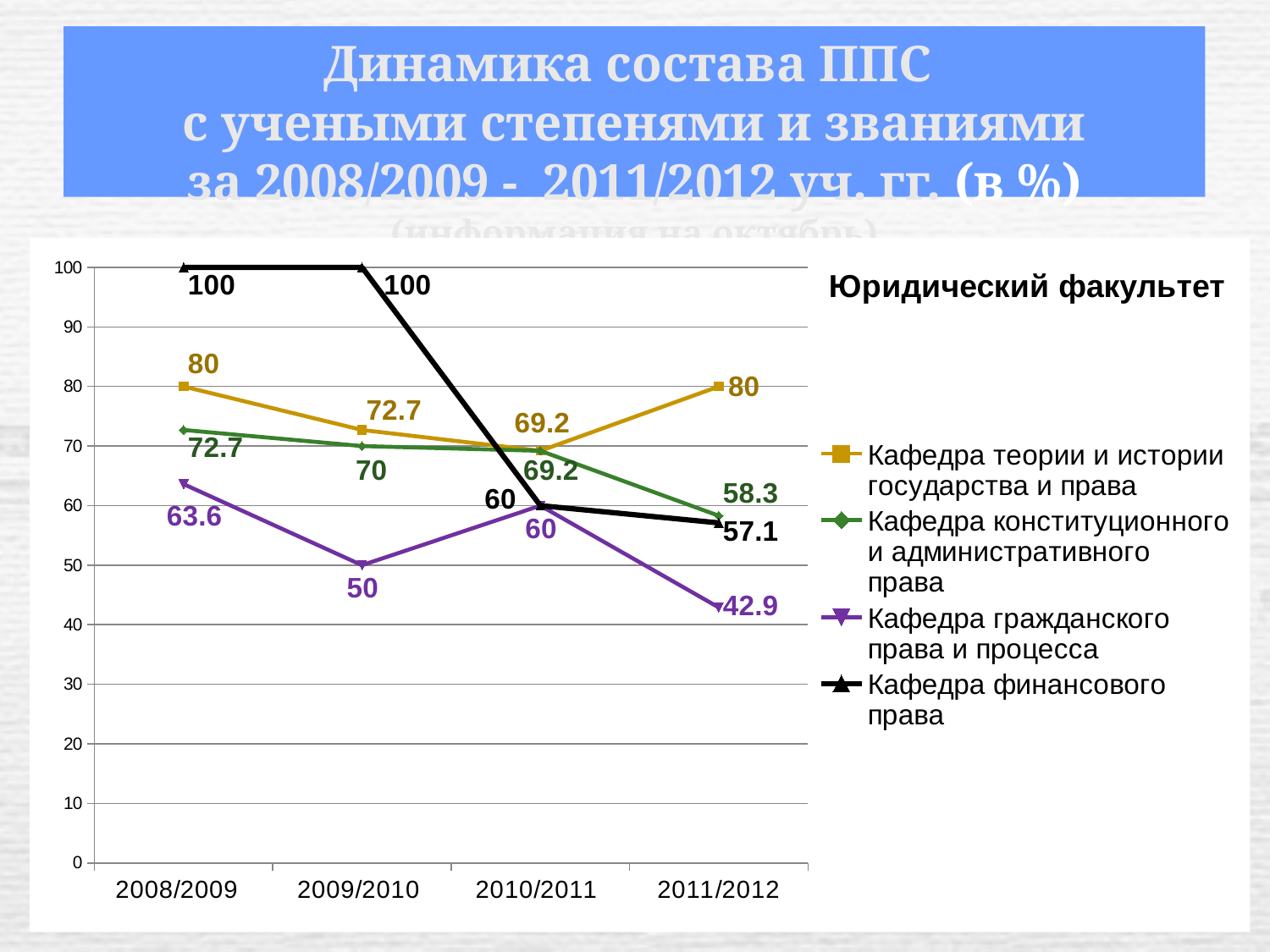
Which series has the highest value in 2011/2012? Кафедра теории и истории государства и права How many academic years are shown on the x axis? 4 How many series does the legend list? 4 Which series has the lowest value in 2009/2010? Кафедра гражданского права и процесса What kind of chart is shown on the slide? line chart What is the value for Кафедра финансового права in 2008/2009? 100 Does the value for Кафедра конституционного и административного права rise or fall from 2008/2009 to 2011/2012? fall What is the value for Кафедра гражданского права и процесса in 2011/2012? 42.9 Which is larger in 2011/2012: the value for Кафедра конституционного и административного права or the value for Кафедра финансового права? Кафедра конституционного и административного права What is the difference between the values for Кафедра финансового права in 2009/2010 and 2010/2011? 40 What is the value for Кафедра конституционного и административного права in 2009/2010? 70 What is the value for Кафедра теории и истории государства и права in 2010/2011? 69.2